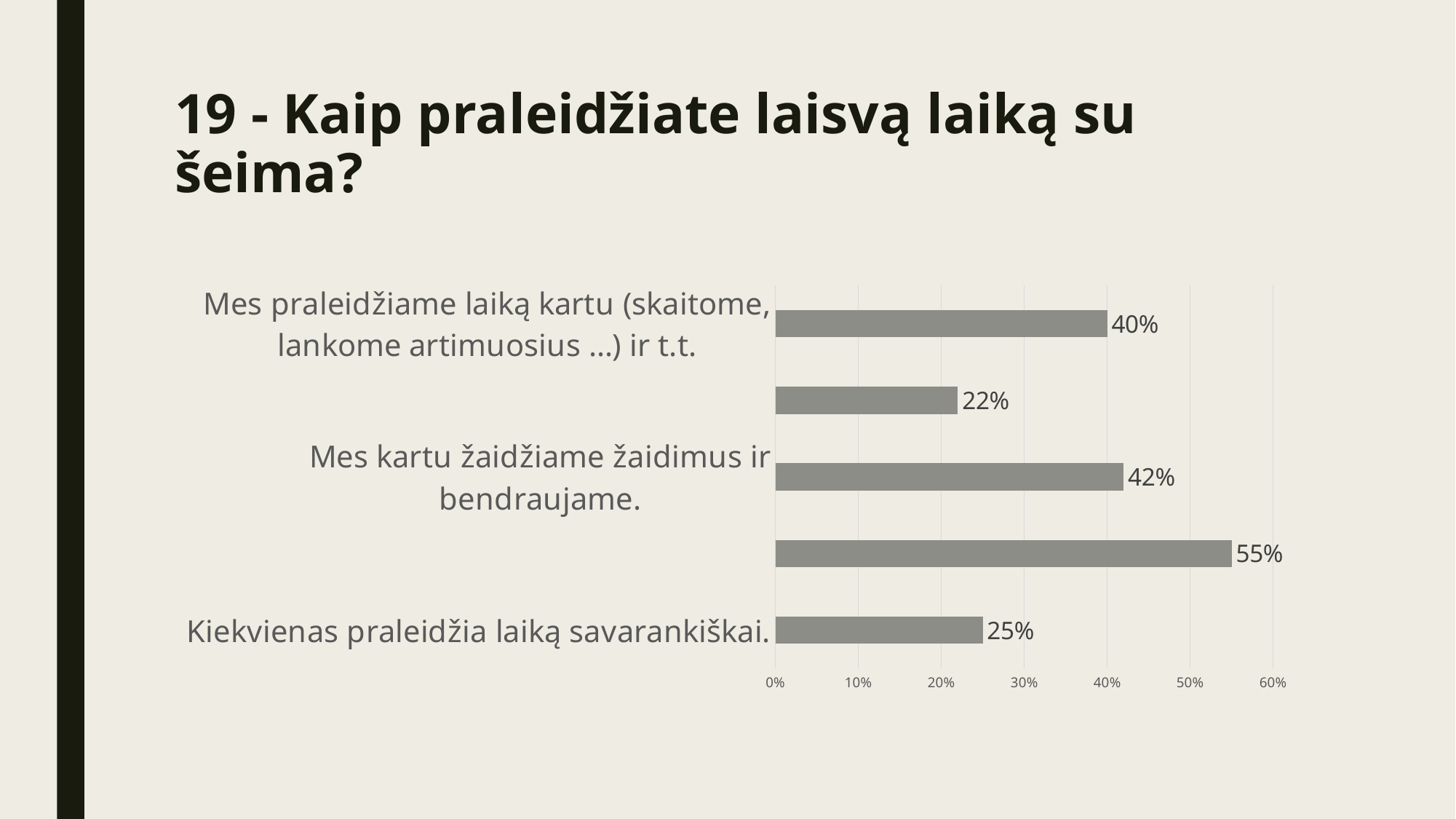
What is the value for "Kiekvienas praleidžia laiką savarankiškai."? 25% What kind of chart is shown on the slide? bar chart What is the value for "Mes praleidžiame laiką kartu (skaitome, lankome artimuosius ...) ir t.t."? 40% What is the difference between the value for "Mes kartu žaidžiame žaidimus ir bendraujame." and the value for "Kiekvienas praleidžia laiką savarankiškai."? 17% What is the highest value shown by any bar in the chart? 55% What is the difference between the value for "Mes praleidžiame laiką kartu (skaitome, lankome artimuosius ...) ir t.t." and the value for "Kiekvienas praleidžia laiką savarankiškai."? 15% What is the value for "Mes kartu žaidžiame žaidimus ir bendraujame."? 42% What is the title of the slide containing the chart? 19 - Kaip praleidžiate laisvą laiką su šeima? What is the lowest value shown by any bar in the chart? 22% Is the value for "Kiekvienas praleidžia laiką savarankiškai." greater or less than 30%? less How many bars are plotted in the chart? 5 Which is larger: the value for "Mes kartu žaidžiame žaidimus ir bendraujame." or the value for "Kiekvienas praleidžia laiką savarankiškai."? Mes kartu žaidžiame žaidimus ir bendraujame.